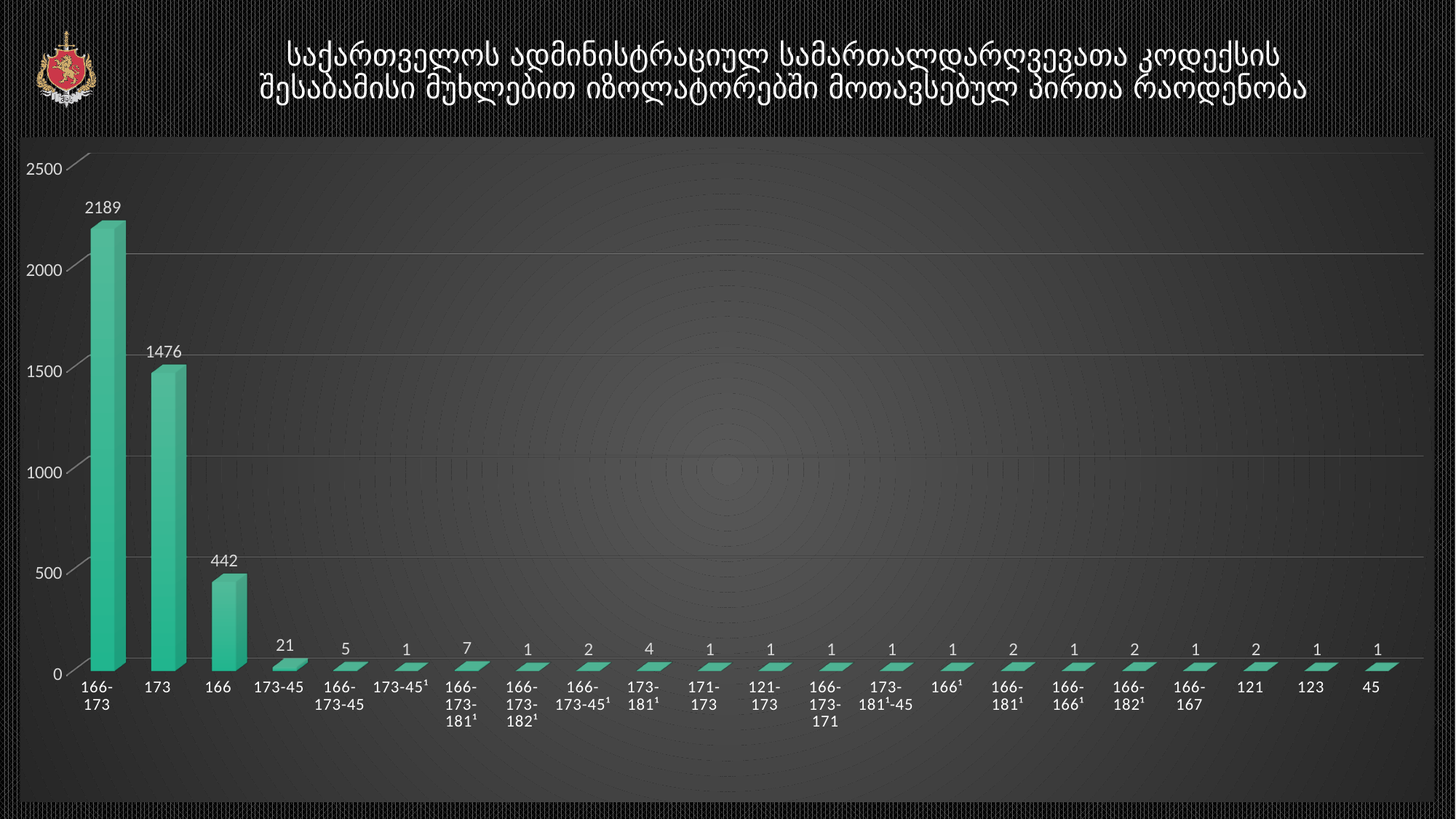
What is the difference between the values for 173 and 166? 1034 Is the value for 173 greater or less than 1000? greater What is the value for the category 166? 442 What is the difference between the values for 166-173 and 173? 713 What is the value for the category 166-173-181¹? 7 What kind of chart is shown on the slide? bar chart What is the value for the category 173-45? 21 Which category has the highest value? 166-173 How many categories are shown on the x axis? 22 What is the value for the category 173? 1476 What is the value for the category 166-173? 2189 Which is larger, the value for 173-45 or the value for 166-173-45? 173-45